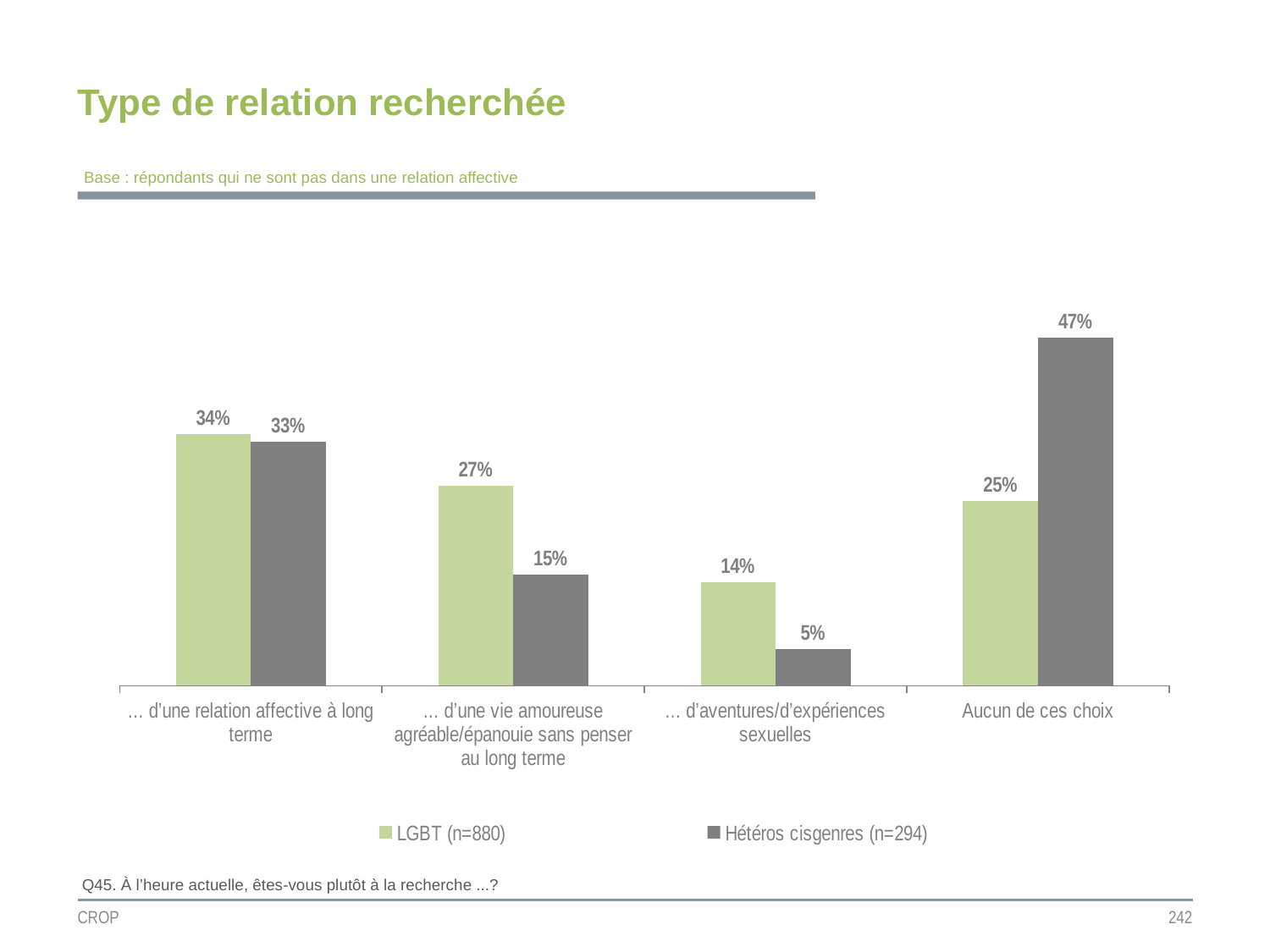
What is the value for Hétéros cisgenres in the "… d'aventures/d'expériences sexuelles" category? 5% What kind of chart is shown on the slide? Bar chart Which category has the highest value for the Hétéros cisgenres series? Aucun de ces choix What is the title of the slide? Type de relation recherchée What is the sample size (n) for the LGBT series shown in the legend? 880 What is the value for Hétéros cisgenres in the "Aucun de ces choix" category? 47% How many categories are shown on the x axis of the chart? 4 In the "Aucun de ces choix" category, which series has the larger value, LGBT or Hétéros cisgenres? Hétéros cisgenres Which category has the lowest value for the LGBT series? … d'aventures/d'expériences sexuelles What percentage of LGBT respondents are looking for a long-term romantic relationship ("… d'une relation affective à long terme")? 34% How many series does the legend list? 2 What is the difference between the LGBT and Hétéros cisgenres values for "… d'une vie amoureuse agréable/épanouie sans penser au long terme"? 12 percentage points